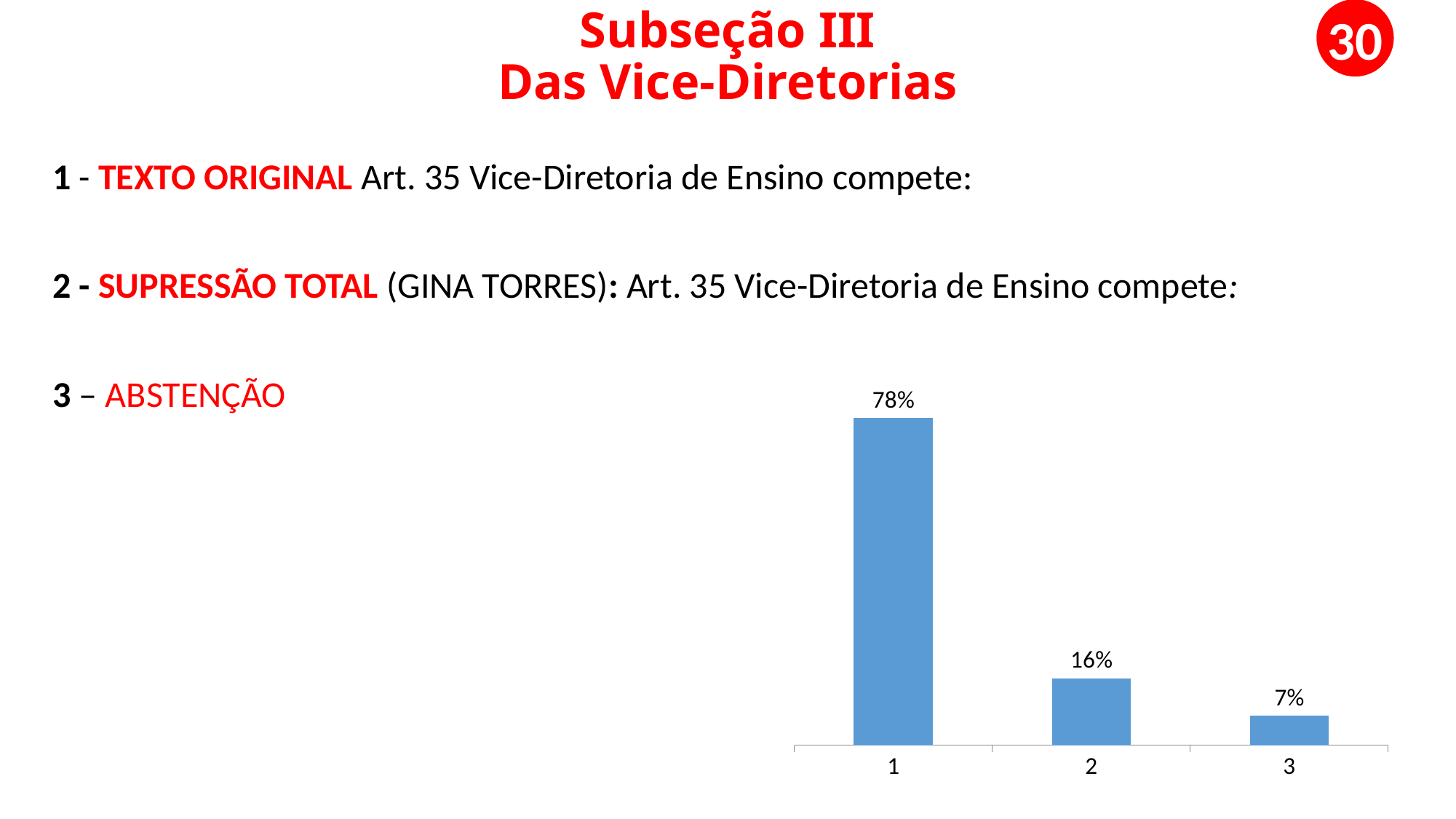
What kind of chart is shown on the slide? bar chart What is the difference between the values for category 2 and category 3? 9% What is the difference between the values for category 1 and category 2? 62% Which category has the lowest value? 3 What is the value for category 1? 78% What is the value for category 2? 16% Which category has the highest value? 1 What is the value for category 3? 7% What colour are the bars in the chart? blue How many categories are shown on the x axis? 3 Which is larger, the value for category 2 or the value for category 3? 2 Do the values rise or fall from category 1 to category 3? fall